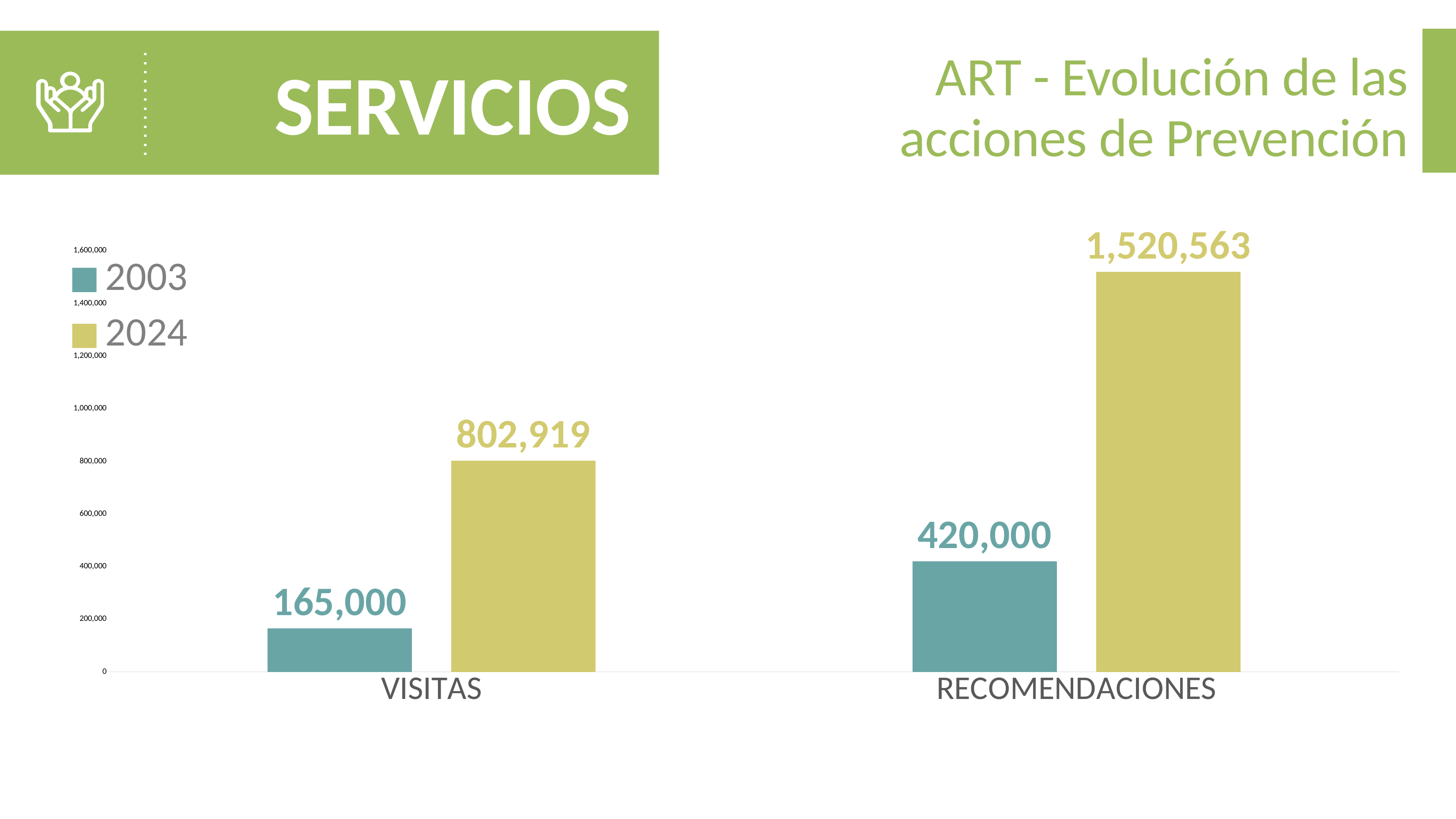
How many categories are shown on the x axis? 2 Which bar has the highest value on the chart? RECOMENDACIONES in 2024 What is the difference between the 2024 and 2003 values for VISITAS? 637,919 Which is larger: VISITAS in 2024 or RECOMENDACIONES in 2003? VISITAS in 2024 What is the value for VISITAS in 2024? 802,919 What is the value for RECOMENDACIONES in 2003? 420,000 How many series does the legend list? 2 What is the value for RECOMENDACIONES in 2024? 1,520,563 What is the value for VISITAS in 2003? 165,000 What kind of chart is shown on the slide? Bar chart Which bar has the lowest value on the chart? VISITAS in 2003 What is the difference between the 2024 and 2003 values for RECOMENDACIONES? 1,100,563